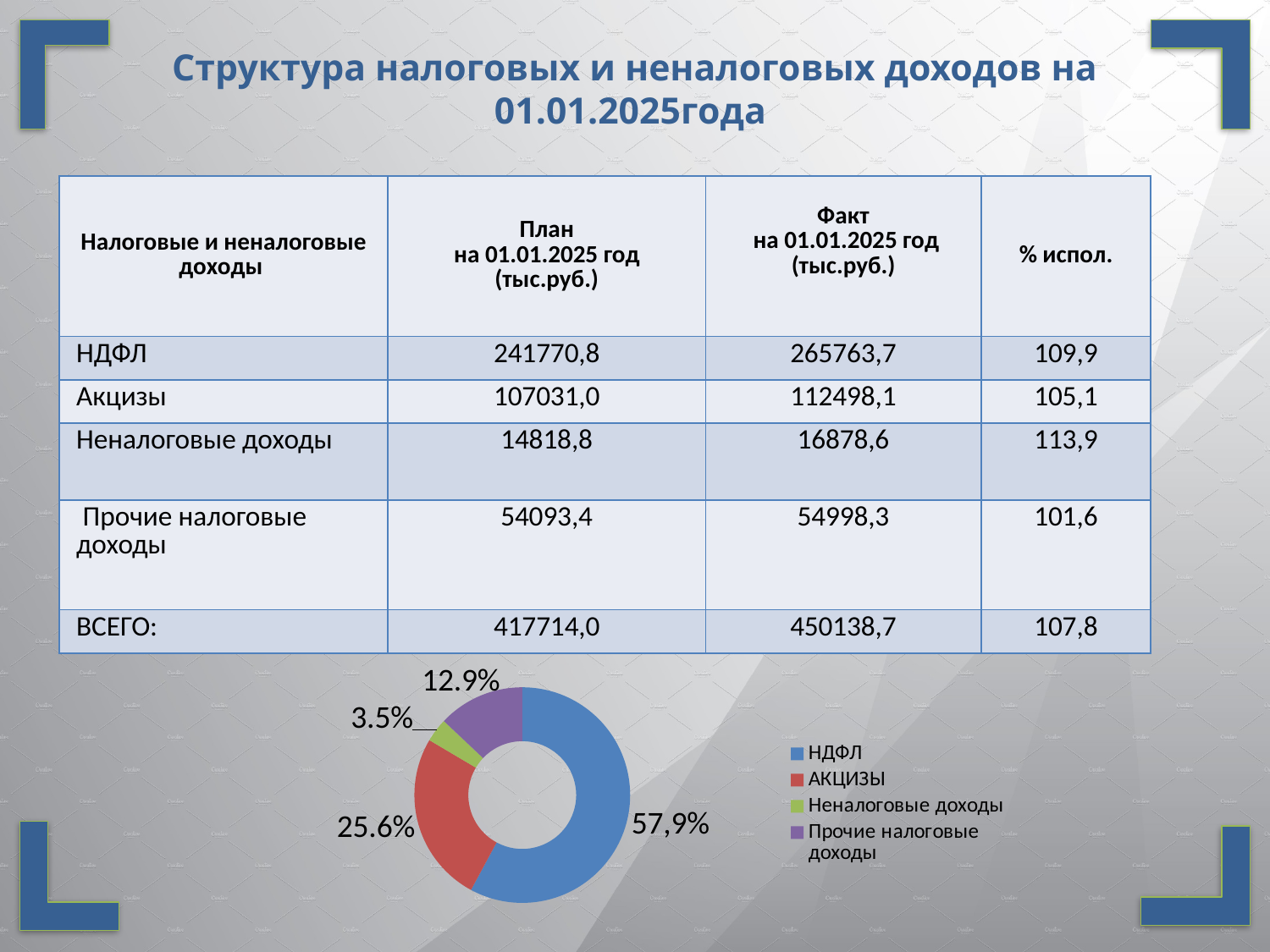
What share of the doughnut chart does НДФЛ have? 57,9% What colour is the Прочие налоговые доходы slice in the doughnut chart? Purple In the doughnut chart, which slice is larger: АКЦИЗЫ or Прочие налоговые доходы? АКЦИЗЫ What share of the doughnut chart does АКЦИЗЫ have? 25.6% How many categories does the legend of the doughnut chart list? 4 Which category has the largest slice in the doughnut chart? НДФЛ What share of the doughnut chart does Прочие налоговые доходы have? 12.9% Which category has the smallest slice in the doughnut chart? Неналоговые доходы What kind of chart is shown at the bottom of the slide? Doughnut (pie) chart What colour is the НДФЛ slice in the doughnut chart? Blue What is the difference in percentage points between the АКЦИЗЫ slice and the Прочие налоговые доходы slice in the doughnut chart? 12.7